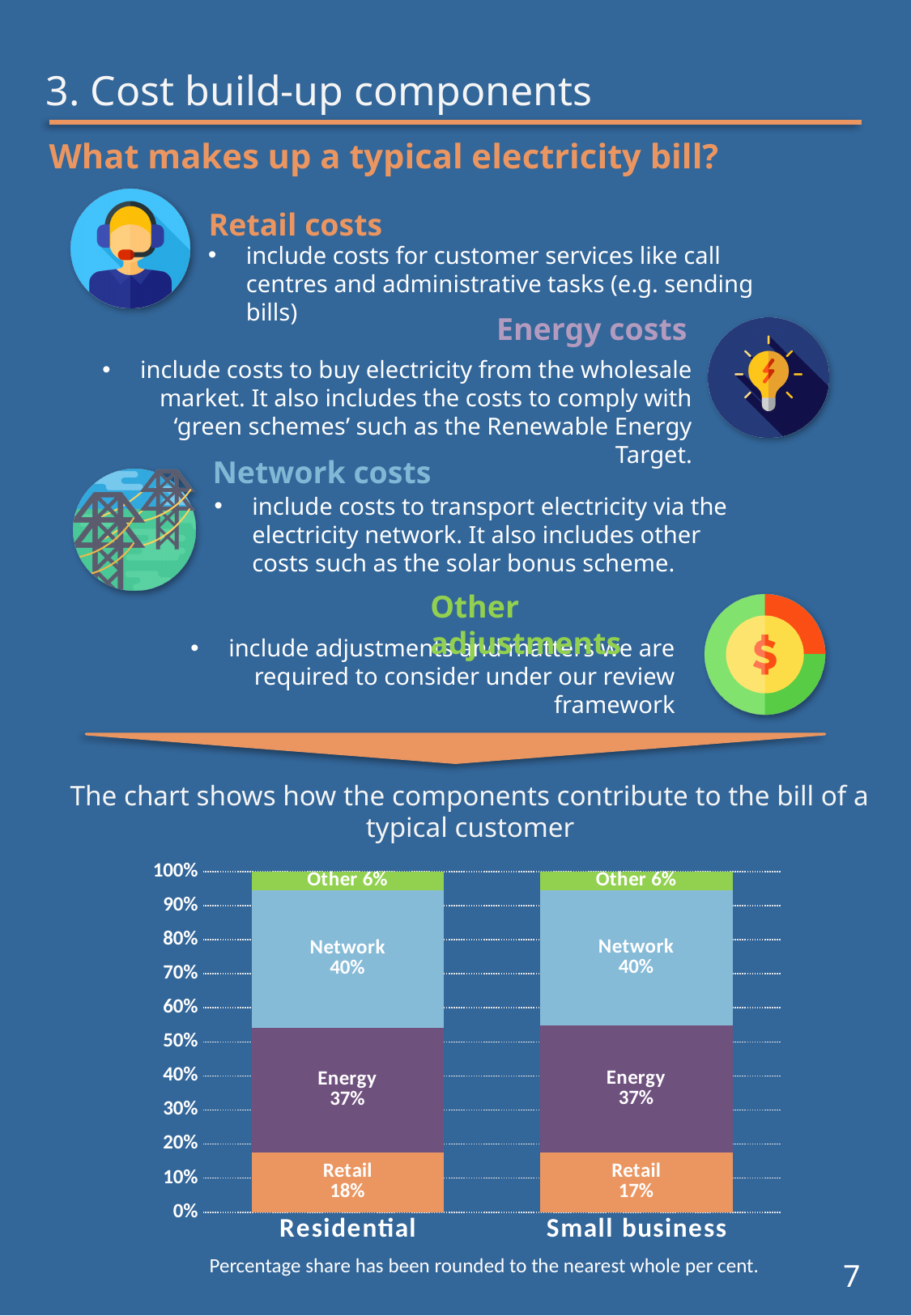
What is the Energy share for Small business? 37% What is the Retail share for Small business? 17% Which component has the largest share in the Residential bar? Network How many categories are shown on the x axis of the chart? 2 How many components are stacked in each bar of the chart? 4 Which component has the smallest share in the Small business bar? Other What is the difference between the Network share and the Energy share for Residential? 3% Which is larger, the Retail share for Residential or the Retail share for Small business? Residential What kind of chart is shown on the slide? Stacked bar chart What is the Other share for Small business? 6% What is the Retail share for Residential? 18% What is the Network share for Residential? 40%